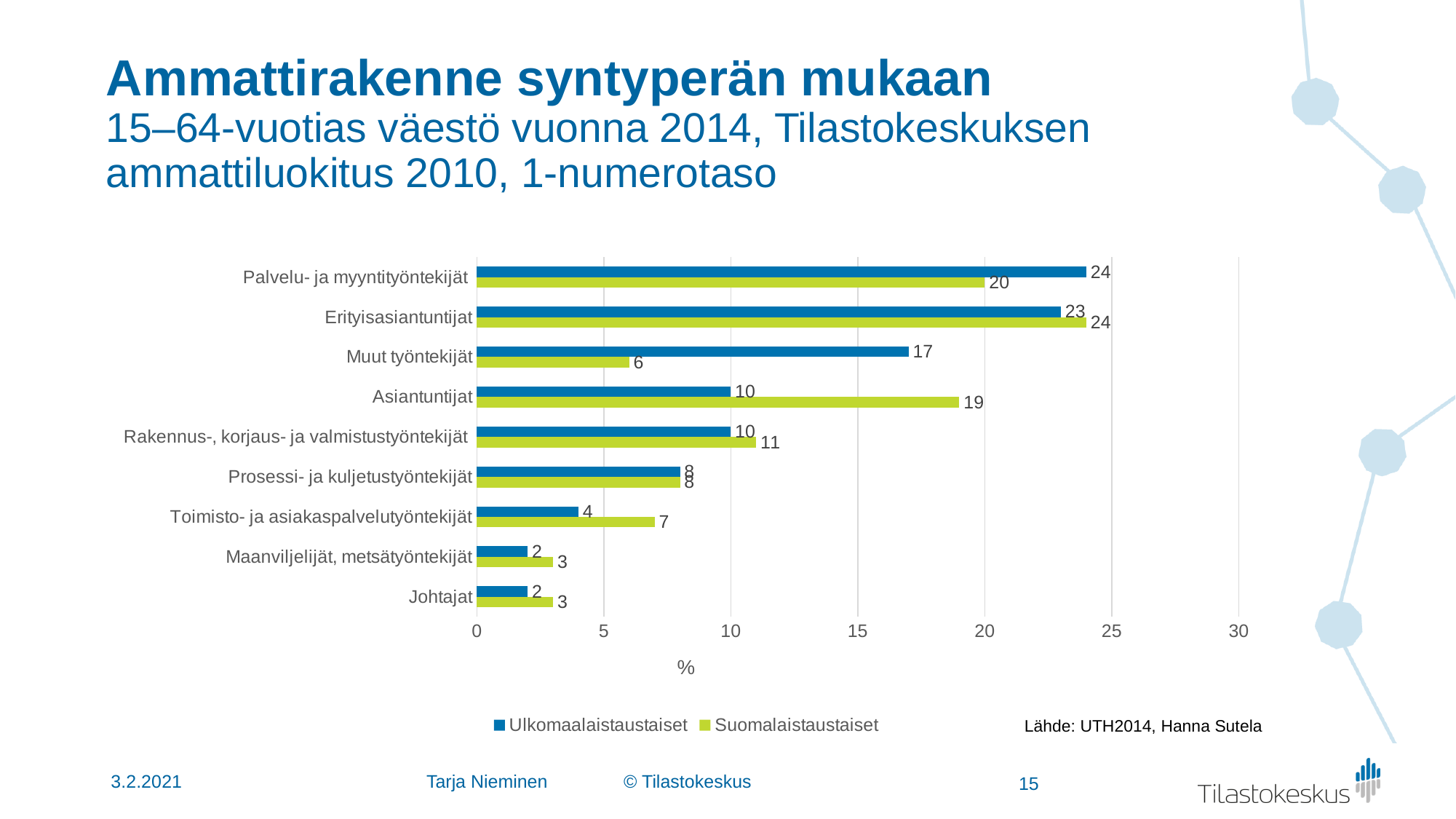
What is the value for Suomalaistaustaiset in the Asiantuntijat category? 19 Is the Ulkomaalaistaustaiset value for Erityisasiantuntijat greater or less than 20? greater Which category has the highest value for Ulkomaalaistaustaiset? Palvelu- ja myyntityöntekijät Which category has the highest value for Suomalaistaustaiset? Erityisasiantuntijat How many occupational categories are shown on the chart? 9 What is the value for Suomalaistaustaiset in the Muut työntekijät category? 6 What is the difference between the Suomalaistaustaiset and Ulkomaalaistaustaiset values for Asiantuntijat? 9 How many series does the legend list? 2 What is the difference between the Ulkomaalaistaustaiset and Suomalaistaustaiset values for Muut työntekijät? 11 What kind of chart is shown on the slide? Bar chart What is the value for Ulkomaalaistaustaiset in the Palvelu- ja myyntityöntekijät category? 24 For Toimisto- ja asiakaspalvelutyöntekijät, which series has the larger value, Ulkomaalaistaustaiset or Suomalaistaustaiset? Suomalaistaustaiset